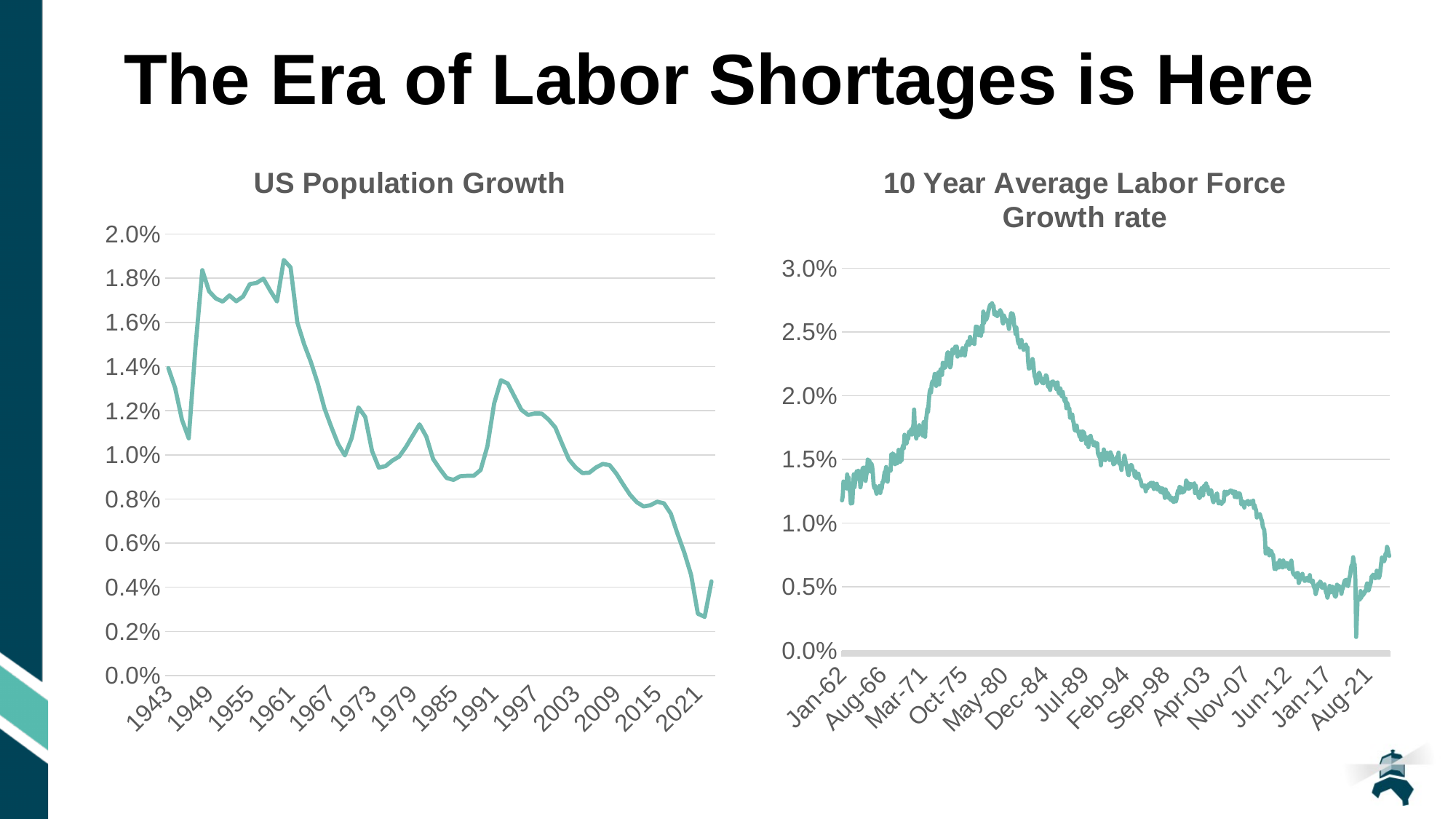
In the 'US Population Growth' chart, is the value for 1961 larger or smaller than the value for 2021? larger In the '10 Year Average Labor Force Growth rate' chart, is the value at Jan-17 greater or less than 1.0%? less In the 'US Population Growth' chart, around which labelled year does the line reach its highest value? 1961 What kind of chart is the 'US Population Growth' chart? Line chart How many year labels are shown on the x axis of the 'US Population Growth' chart? 14 In the '10 Year Average Labor Force Growth rate' chart, around which labelled date does the line peak? May-80 In the 'US Population Growth' chart, is the value for 2015 greater or less than 1.0%? less In the '10 Year Average Labor Force Growth rate' chart, does the line generally rise or fall between May-80 and Jan-17? fall What kind of chart is the '10 Year Average Labor Force Growth rate' chart? Line chart In the '10 Year Average Labor Force Growth rate' chart, is the value at May-80 greater or less than 2.5%? greater